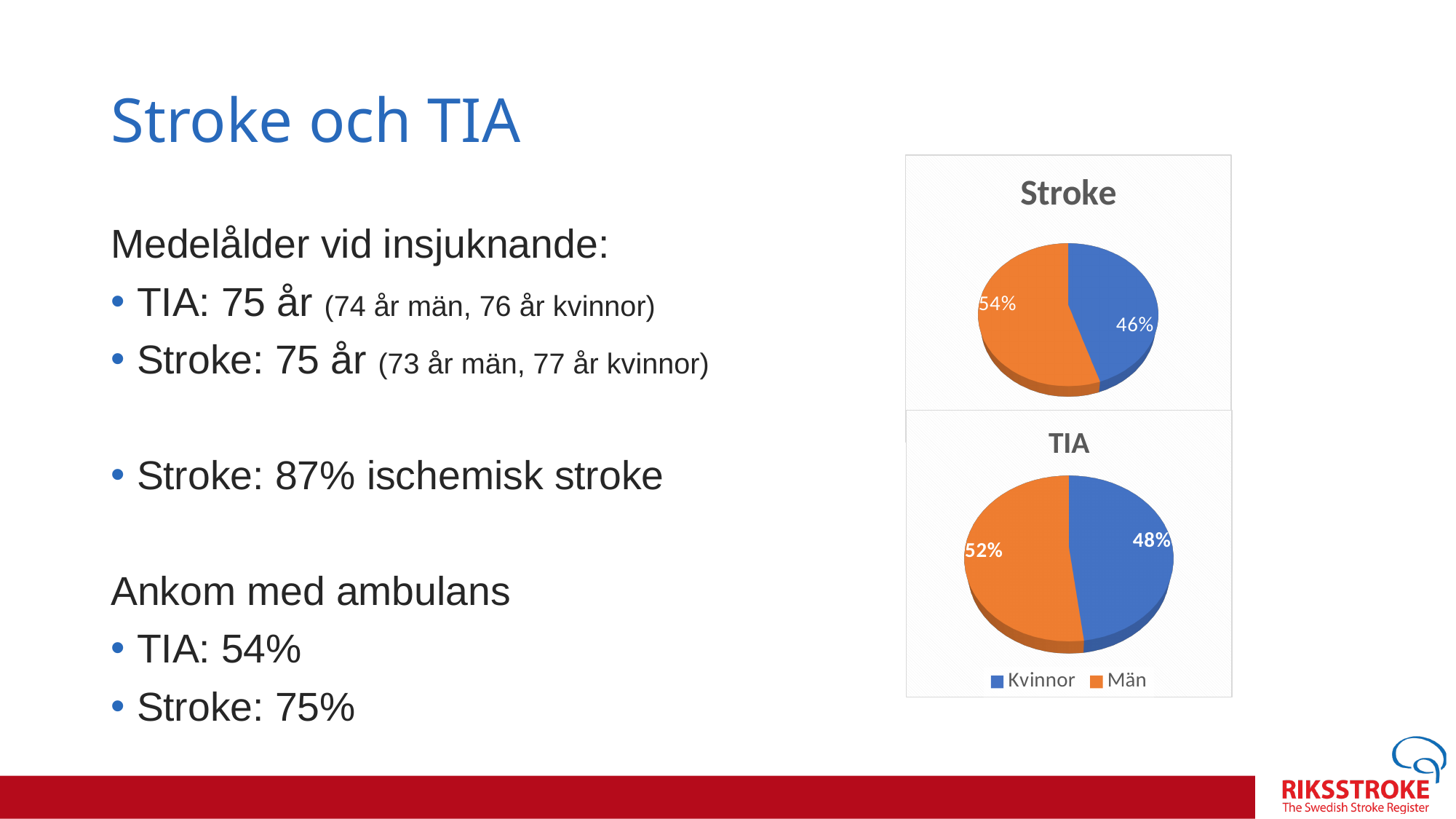
Is the Kvinnor share larger in the Stroke pie chart or in the TIA pie chart? TIA How many categories does the legend of the TIA pie chart list? 2 In the TIA pie chart, which colour represents Män? Orange In the TIA pie chart, what share is labelled for Kvinnor? 48% In the Stroke pie chart, what share is labelled for Kvinnor? 46% In the Stroke pie chart, what share is labelled for Män? 54% In the Stroke pie chart, which group has the larger slice? Män In the Stroke pie chart, what is the difference in percentage points between Män and Kvinnor? 8 In the TIA pie chart, which group has the smaller slice? Kvinnor In the TIA pie chart, what share is labelled for Män? 52% What type of chart is used for the Stroke and TIA charts? Pie chart In the TIA pie chart, what is the difference in percentage points between Män and Kvinnor? 4